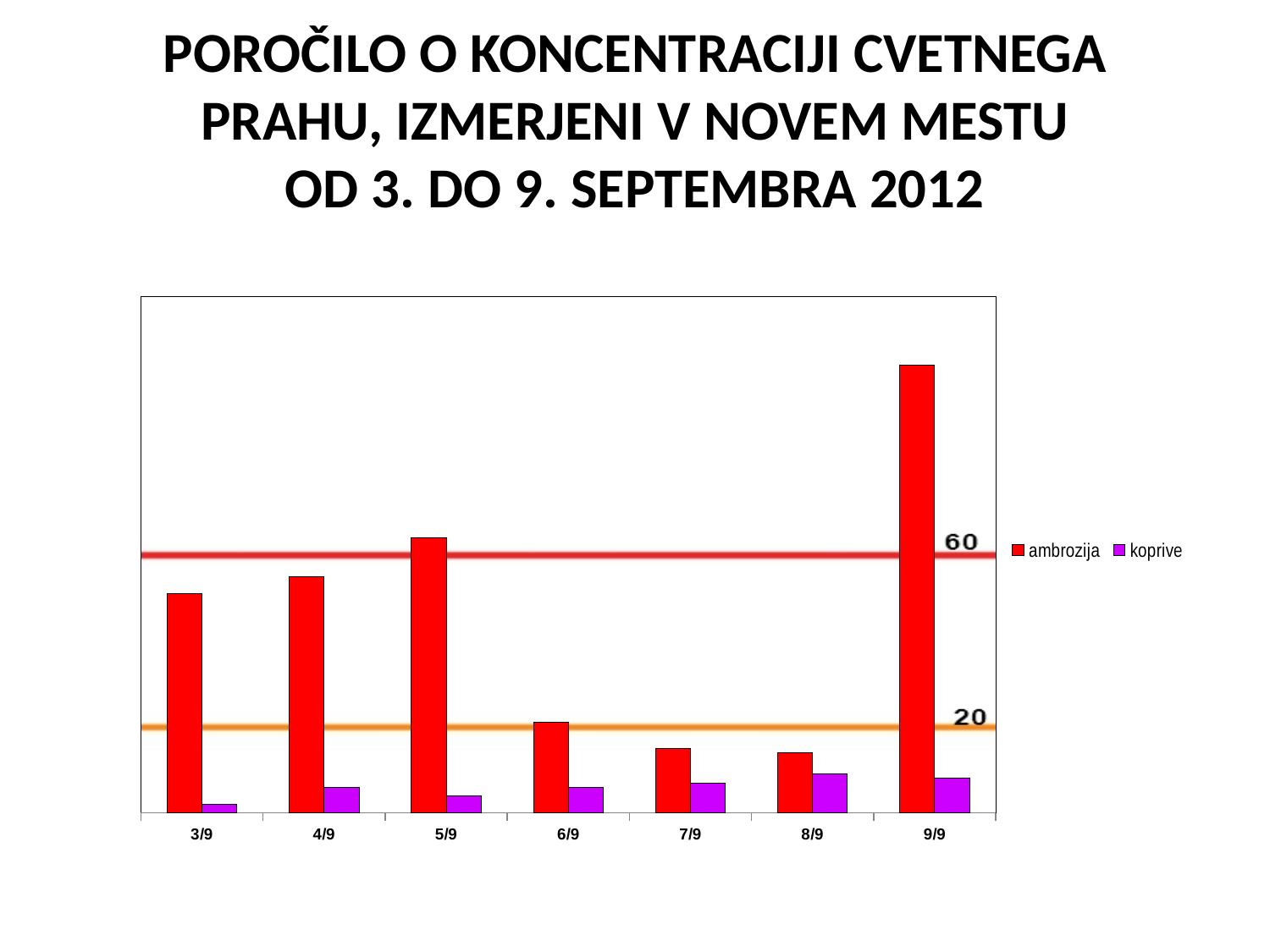
Is the koprive value for 8/9 greater or less than 20? less What kind of chart is shown on the slide? bar chart Which date has the lowest koprive value? 3/9 What colour are the ambrozija bars? red Is the ambrozija value for 7/9 greater or less than 20? less Do the ambrozija values rise or fall from 3/9 to 5/9? rise How many dates are shown on the x axis? 7 How many series does the legend list? 2 Is the ambrozija value for 3/9 greater or less than 60? less Which is larger on 3/9, the ambrozija value or the koprive value? ambrozija Which date has the highest ambrozija value? 9/9